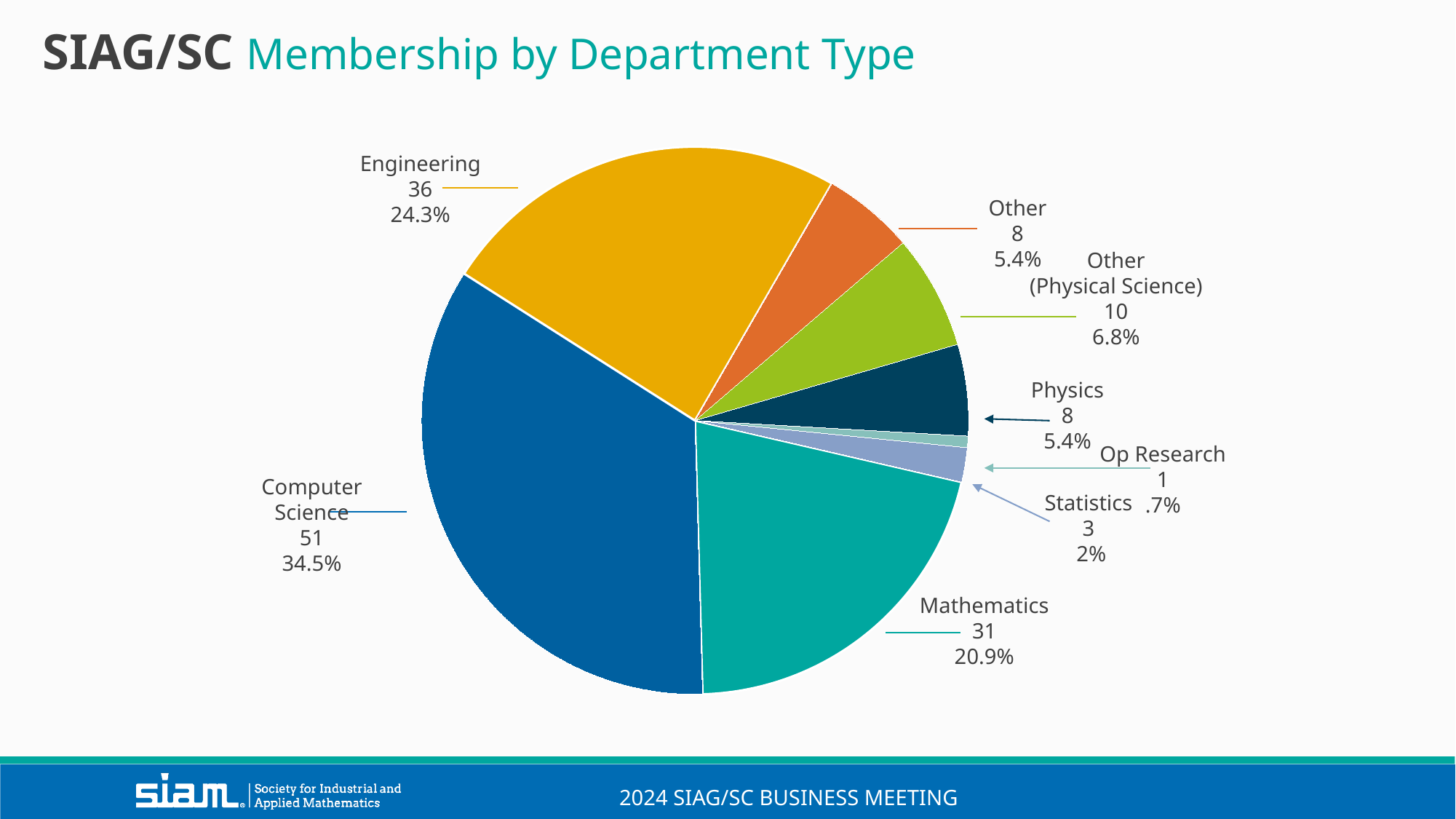
What kind of chart is shown on the slide? pie chart What is the value shown for Other (Physical Science)? 10 How many slices does the pie chart have? 8 What is the value shown for Mathematics? 31 What percentage share does Statistics have? 2% How many members are in the Computer Science slice? 51 Which department type has the smallest slice? Op Research What percentage share does Engineering have? 24.3% Which is larger, the Other (Physical Science) slice or the Physics slice? Other (Physical Science) What is the difference between the Computer Science and Engineering values? 15 What is the title of the chart? SIAG/SC Membership by Department Type Which department type has the largest slice? Computer Science